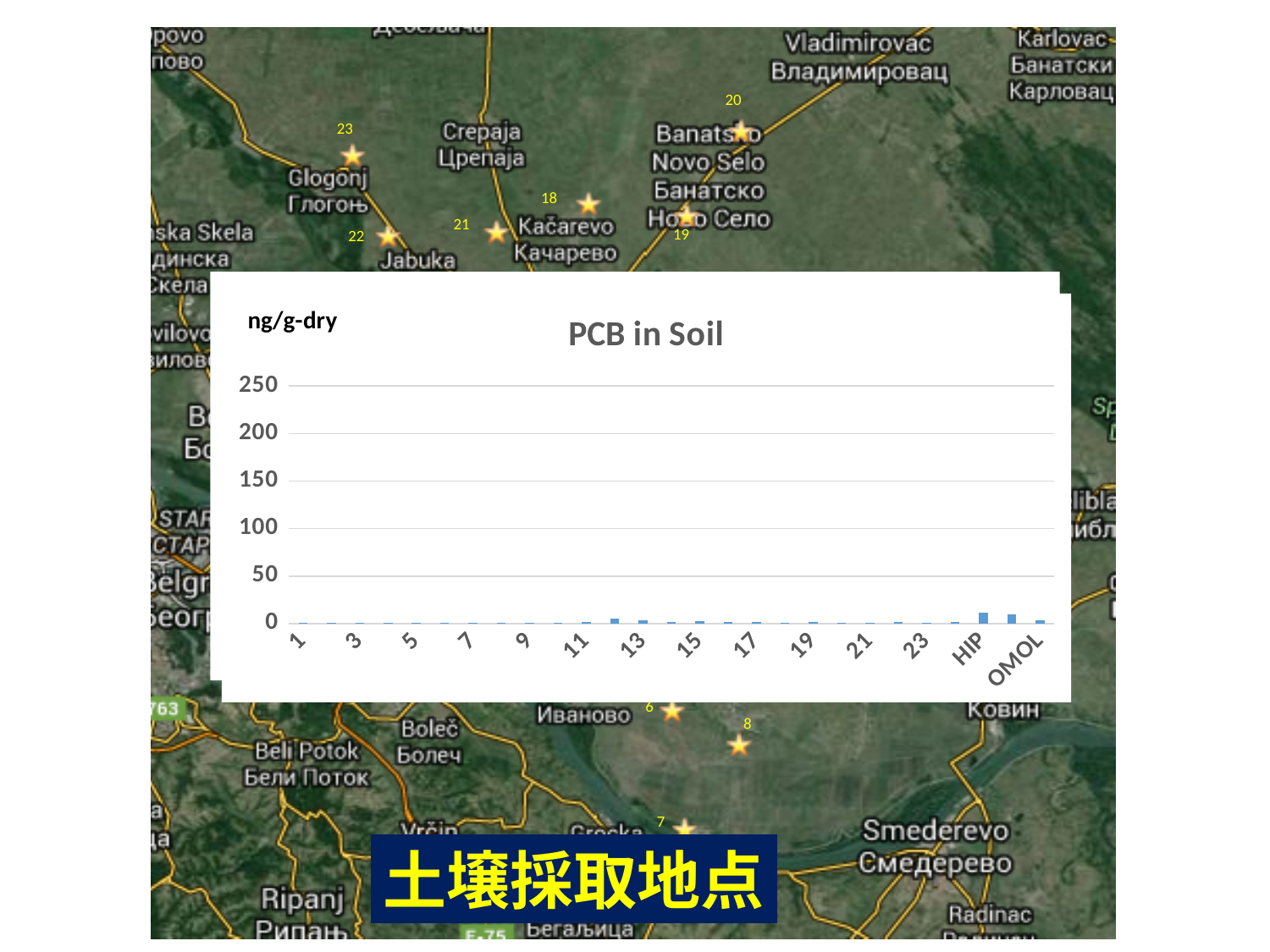
Is the value for site 12 greater or less than 100? less Which has the larger value, OMOL or site 3? OMOL Which has the larger value, site 12 or site 11? 12 Is the value for site 1 greater or less than 50? less Which has the larger value, HIP or site 1? HIP What kind of chart is shown on the slide? bar chart Is the value for OMOL greater or less than 50? less How many categories are plotted on the x axis of the chart? 27 What unit is shown for the values in the chart? ng/g-dry What is the title of the chart? PCB in Soil